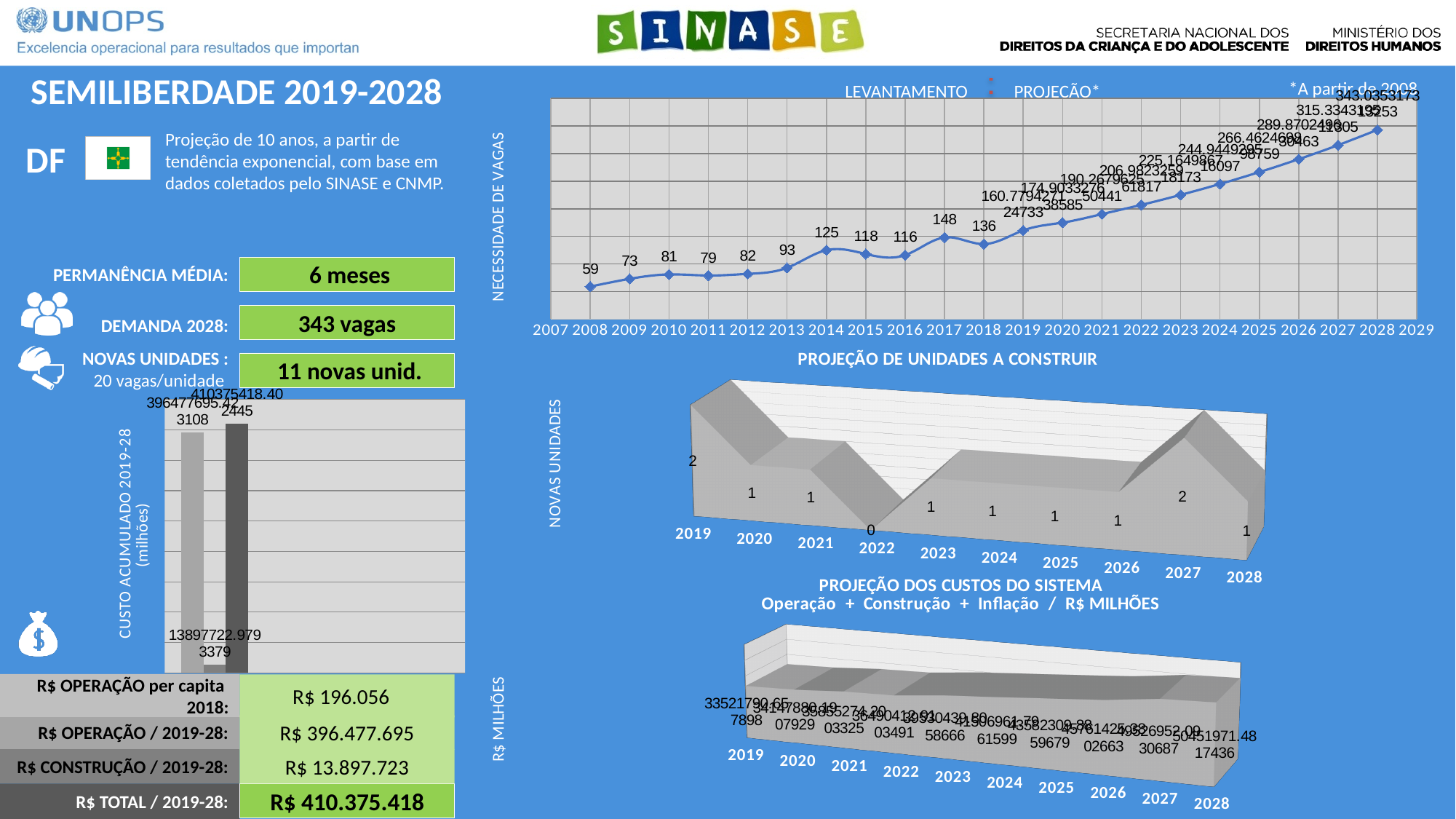
In the NECESSIDADE DE VAGAS line chart, what is the value for 2014? 125 In the PROJEÇÃO DE UNIDADES A CONSTRUIR chart, what is the value for 2022? 0 In the NECESSIDADE DE VAGAS line chart, what is the value for 2017? 148 In the NECESSIDADE DE VAGAS line chart, what is the value for 2008? 59 In the NECESSIDADE DE VAGAS line chart, which is larger, the value for 2014 or the value for 2015? 2014 In the NECESSIDADE DE VAGAS line chart, do the values generally rise or fall from 2008 to 2028? rise In the PROJEÇÃO DE UNIDADES A CONSTRUIR chart, what is the value for 2019? 2 What kind of chart is the NECESSIDADE DE VAGAS chart at the top right? line chart How many years are shown on the x axis of the PROJEÇÃO DE UNIDADES A CONSTRUIR chart? 10 In the NECESSIDADE DE VAGAS line chart, what is the difference between the values for 2017 and 2018? 12 In the NECESSIDADE DE VAGAS line chart, which year has the lowest value? 2008